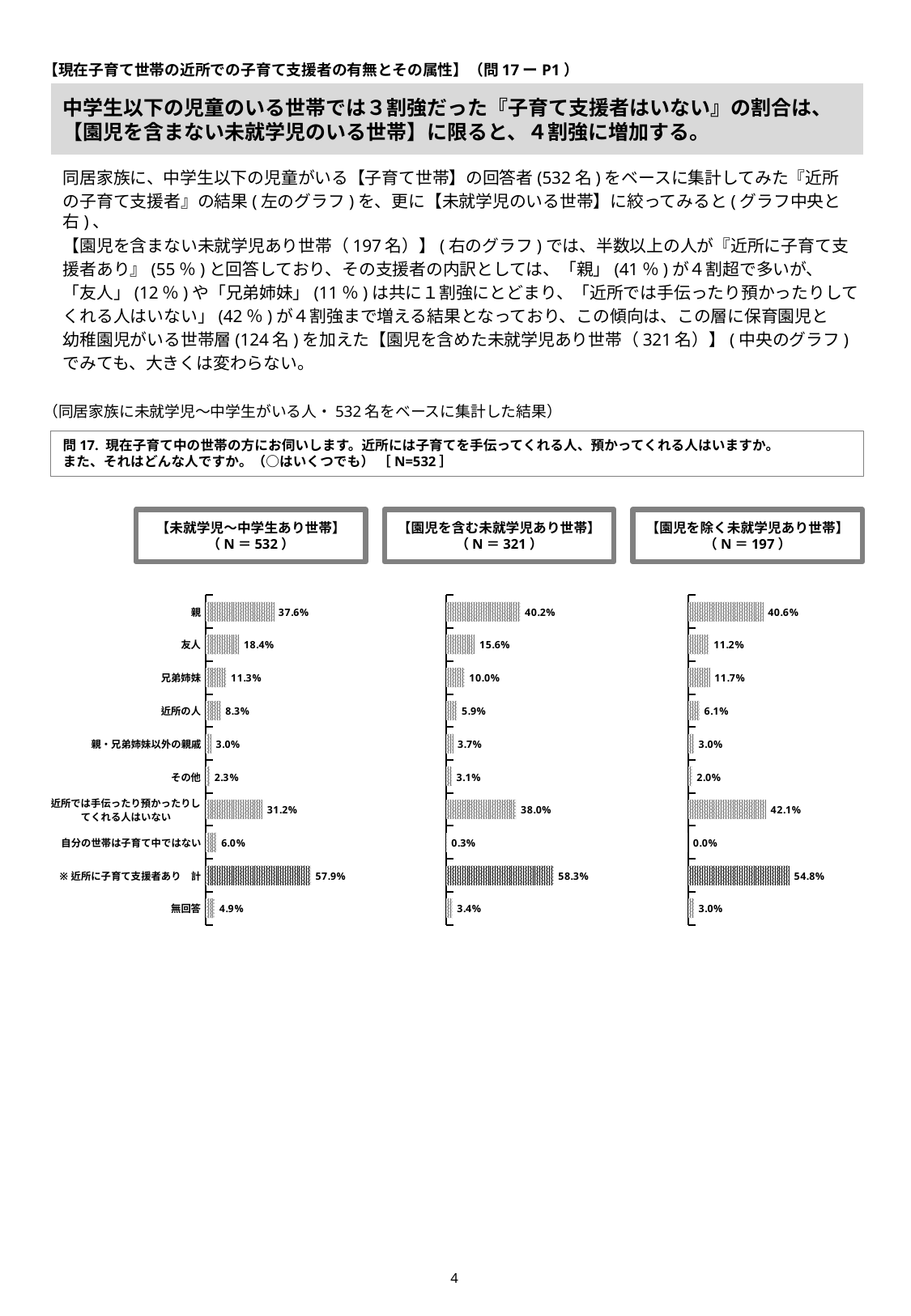
In the right chart 【園児を除く未就学児あり世帯】(N=197), what is the difference between 近所では手伝ったり預かったりしてくれる人はいない and 親? 1.5% In the left chart 【未就学児～中学生あり世帯】(N=532), what is the value for 親? 37.6% In the left chart 【未就学児～中学生あり世帯】(N=532), which category has the lowest value? その他 What type of chart is used on this slide? Bar chart How many bar charts are shown on the slide? 3 In the middle chart 【園児を含む未就学児あり世帯】(N=321), what is the value for 近所では手伝ったり預かったりしてくれる人はいない? 38.0% How many categories are shown in each of the three bar charts? 10 In the left chart 【未就学児～中学生あり世帯】(N=532), what is the difference between 親 and 近所では手伝ったり預かったりしてくれる人はいない? 6.4% In the right chart 【園児を除く未就学児あり世帯】(N=197), what is the value for 自分の世帯は子育て中ではない? 0.0% In the right chart 【園児を除く未就学児あり世帯】(N=197), what is the value for 友人? 11.2% In the middle chart 【園児を含む未就学児あり世帯】(N=321), which is larger, 友人 or 兄弟姉妹? 友人 In the right chart 【園児を除く未就学児あり世帯】(N=197), which category has the highest value? ※近所に子育て支援者あり 計